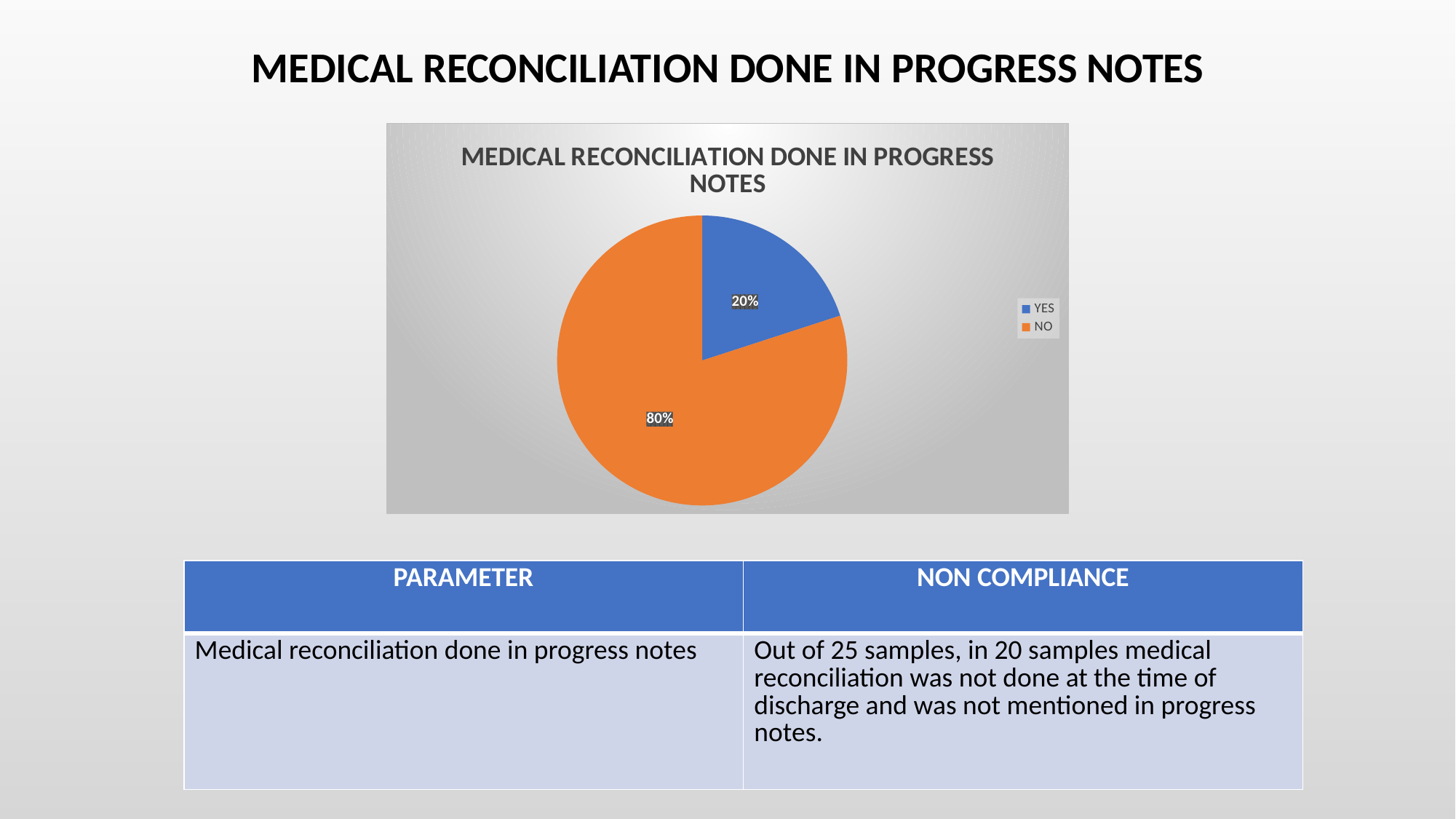
Which category has the smallest share of the pie? YES What is the difference in percentage points between the NO slice and the YES slice? 60% How many slices does the pie chart have? 2 What percentage of the pie is labelled NO? 80% Which is larger, the YES slice or the NO slice? NO What share of the pie does the YES slice represent? 20% How many entries does the legend list? 2 What kind of chart is shown on the slide? pie chart What percentage of the pie is labelled YES? 20% What is the title of the chart? MEDICAL RECONCILIATION DONE IN PROGRESS NOTES Which category has the largest share of the pie? NO What colour is the NO slice? orange